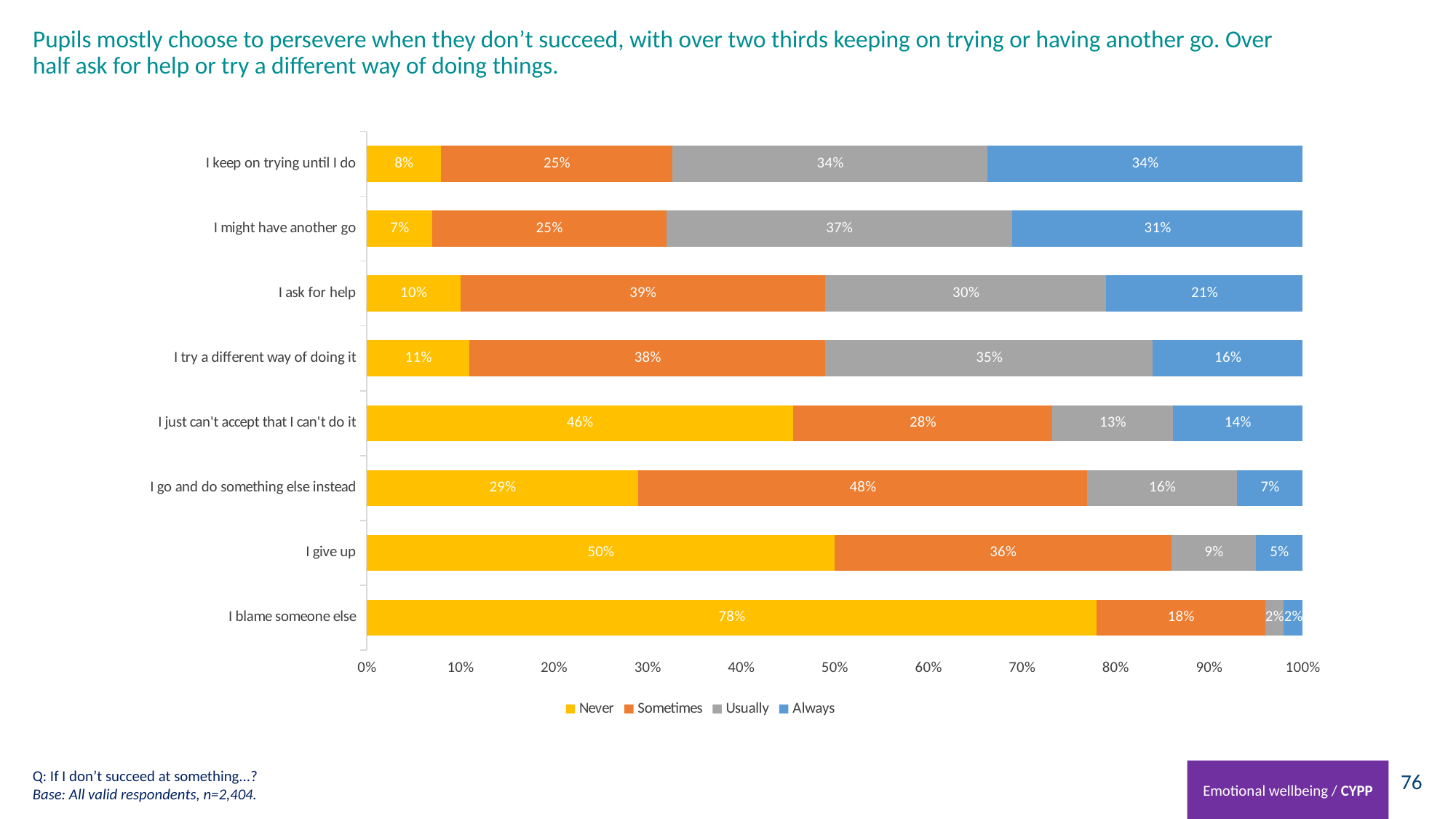
Which colour represents the 'Sometimes' response in the chart? Orange What percentage of pupils say they 'Usually' ask for help? 30% What percentage of pupils say they 'Never' blame someone else? 78% Which statement has the lowest 'Always' percentage? I blame someone else Which is larger: the 'Always' percentage for 'I might have another go' or for 'I ask for help'? I might have another go What percentage of pupils say they 'Always' keep on trying until they do? 34% How many series does the legend list? 4 How many statements (categories) are shown in the chart? 8 What is the difference between the 'Never' percentage for 'I give up' and for 'I go and do something else instead'? 21% What percentage of pupils say they 'Sometimes' go and do something else instead? 48% Which statement has the highest 'Never' percentage? I blame someone else What kind of chart is shown on the slide? Stacked bar chart